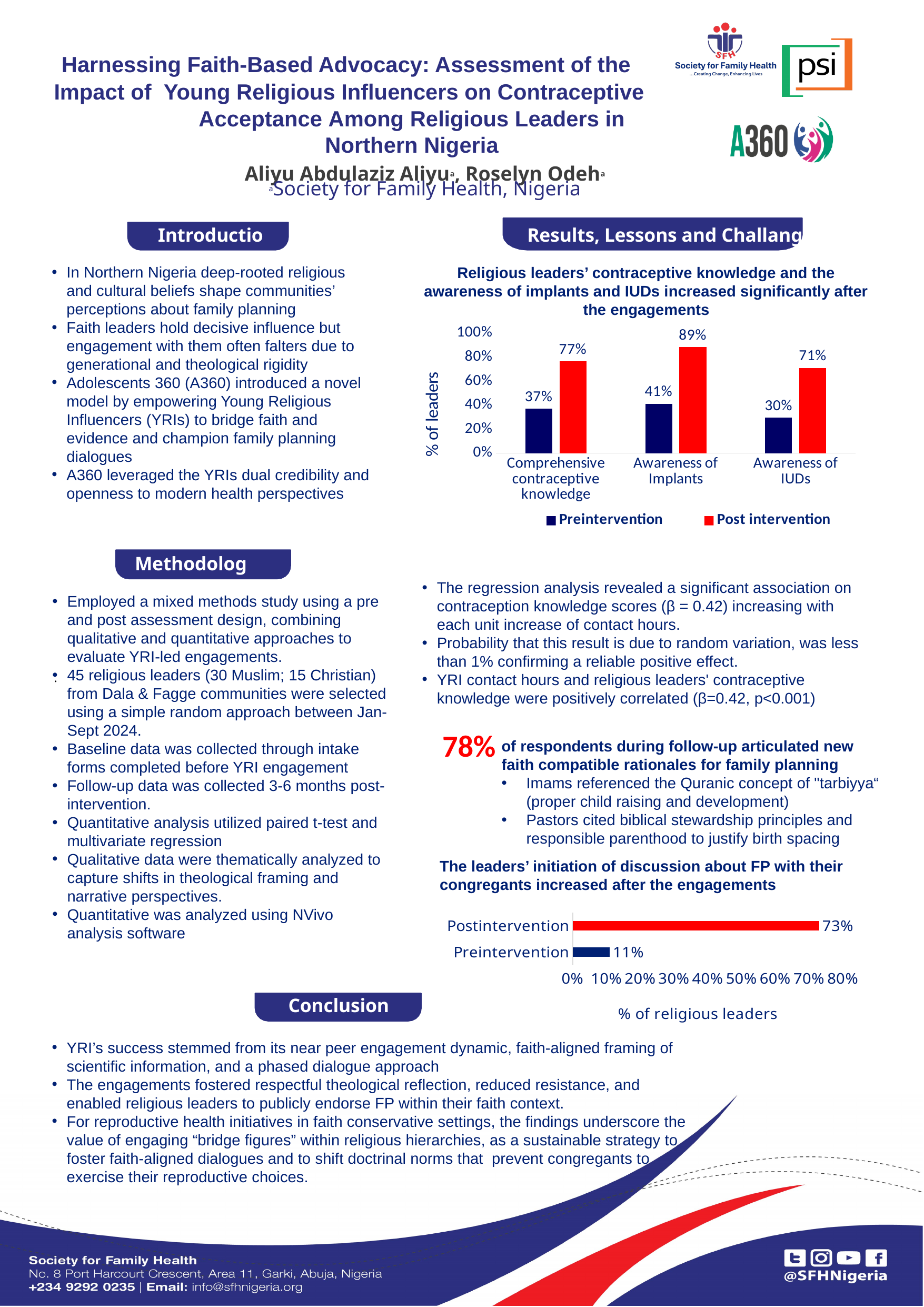
In the chart titled 'Religious leaders' contraceptive knowledge and the awareness of implants and IUDs increased significantly after the engagements', what is the Preintervention value for Comprehensive contraceptive knowledge? 37% In the chart titled 'The leaders' initiation of discussion about FP with their congregants increased after the engagements', what is the Postintervention value? 73% In the top chart on the right, which colour represents Post intervention? Red In the top chart on the right, what is the Post intervention value for Awareness of Implants? 89% What kind of chart is the bottom chart on the right? Bar chart In the top chart on the right, which category has the highest Post intervention value? Awareness of Implants In the bottom chart on the right, what is the difference between the Postintervention and Preintervention values? 62% In the top chart on the right, what is the difference between the Post intervention and Preintervention values for Comprehensive contraceptive knowledge? 40% In the top chart on the right, how many series does the legend list? 2 In the top chart on the right, what is the Post intervention value for Awareness of IUDs? 71% In the top chart on the right, which category has the lowest Preintervention value? Awareness of IUDs In the top chart on the right, how many categories are shown on the x axis? 3